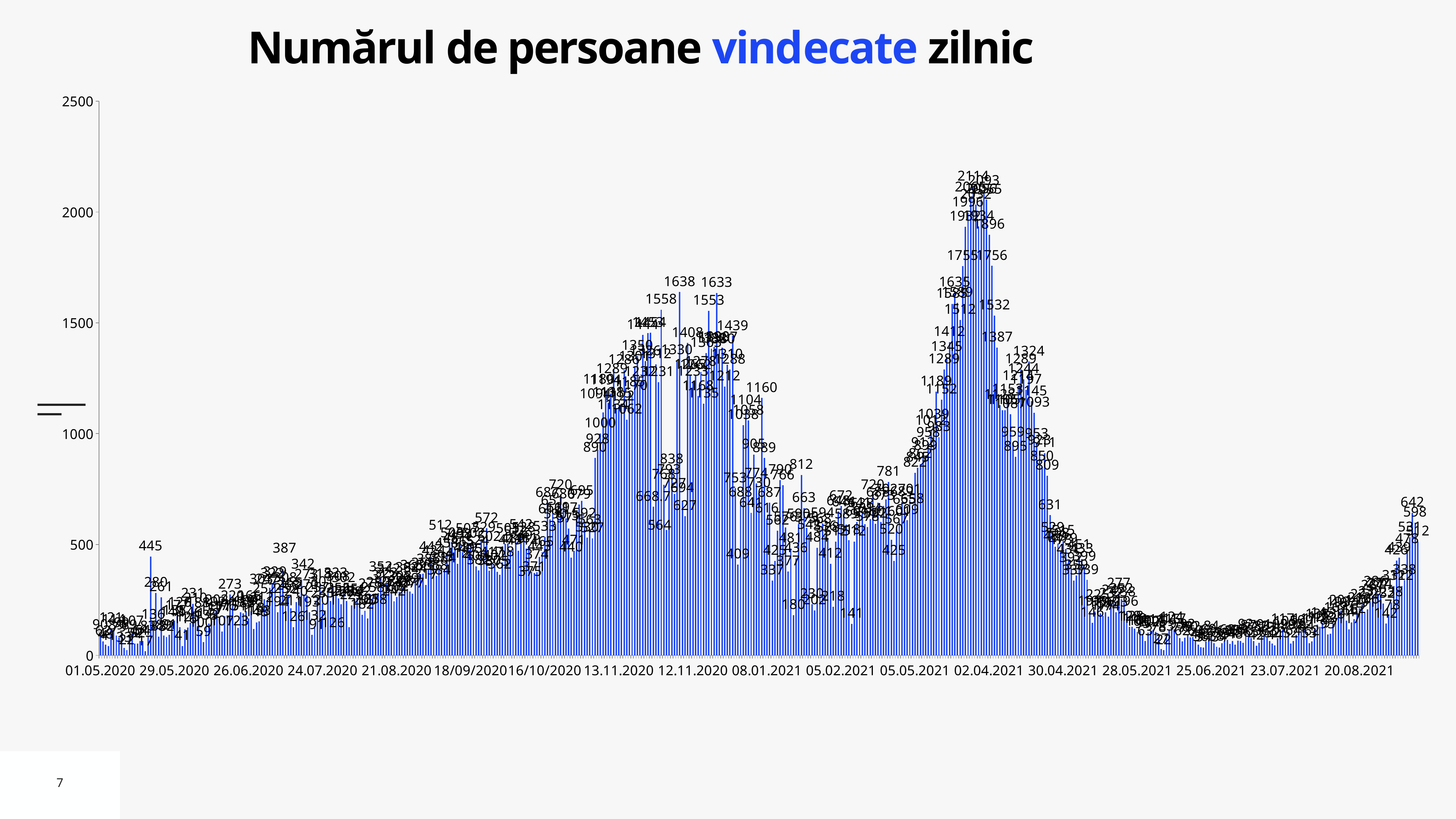
Are the values around 25.06.2021 greater or less than 500? less What kind of chart is shown on the slide? bar chart Do the values rise or fall between 25.06.2021 and 20.08.2021? rise Which peak is higher: the one near 02.04.2021 or the one near 12.11.2020? the one near 02.04.2021 What is the difference between the peak value 2114 (near 02.04.2021) and the peak value 1638 (near 12.11.2020)? 476 What is the value of the tall isolated bar labelled just before 29.05.2020? 445 How many date labels are shown on the horizontal axis? 18 What is the title of the chart? Numărul de persoane vindecate zilnic What is the highest value labelled at the far right end of the chart, near the last bars after 20.08.2021? 642 What is the highest tick value shown on the vertical axis? 2500 Is the value for the first bar at 01.05.2020 greater or less than 500? less What is the highest value labelled on the chart, at the peak near 02.04.2021? 2114